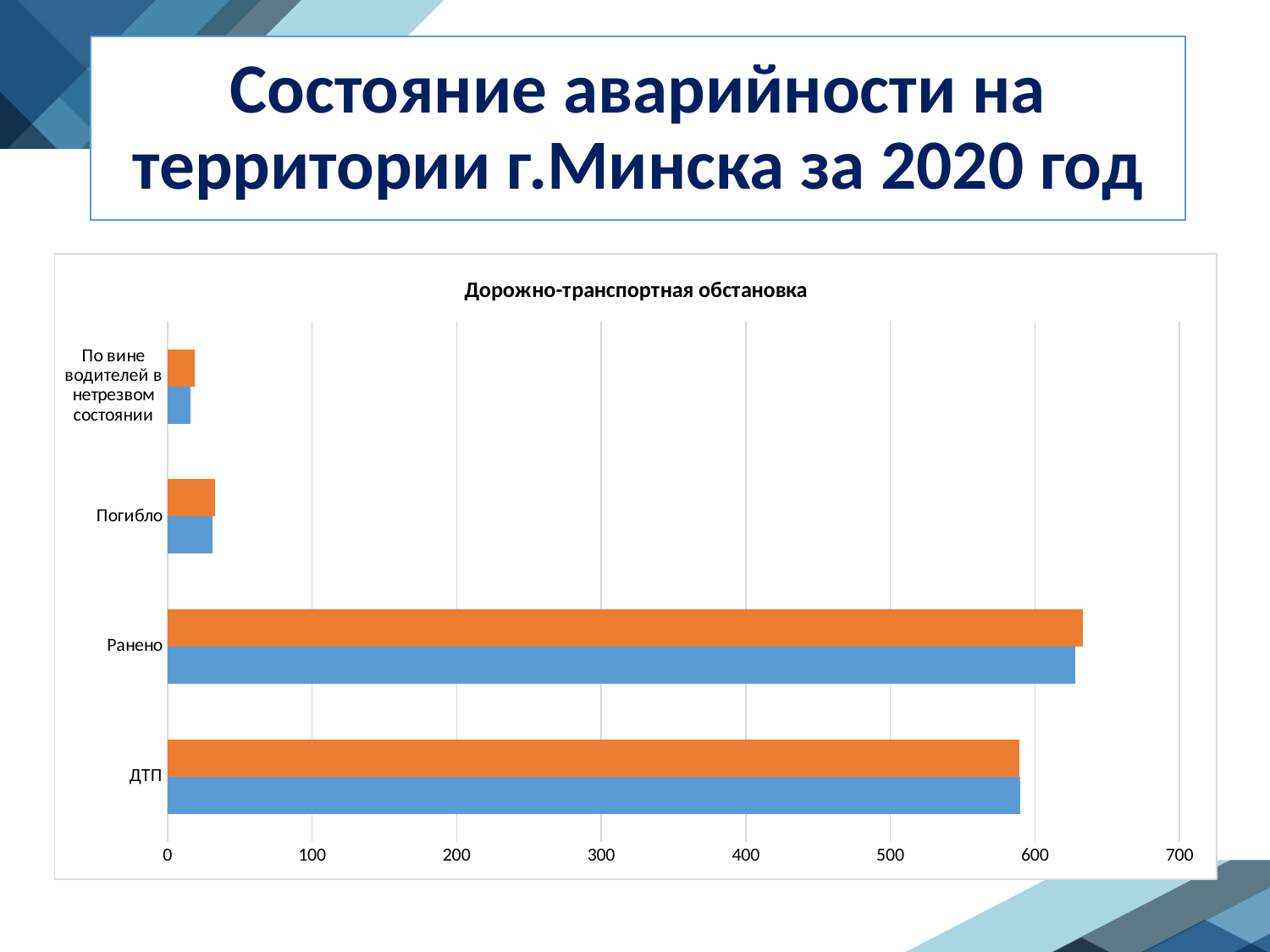
Is the orange bar for Погибло greater or less than 100? less Is the blue bar for Ранено greater or less than 500? greater Is the blue bar for ДТП greater or less than 600? less How many categories are shown on the vertical axis of the chart? 4 What is the highest value shown on the horizontal axis of the chart? 700 Which is larger: the blue bar for Погибло or the blue bar for По вине водителей в нетрезвом состоянии? Погибло Which category has the shortest blue bar? По вине водителей в нетрезвом состоянии Which is larger: the orange bar for Ранено or the orange bar for ДТП? Ранено Which category has the longest orange bar? Ранено What kind of chart is shown on the slide? bar chart What is the title of the chart? Дорожно-транспортная обстановка